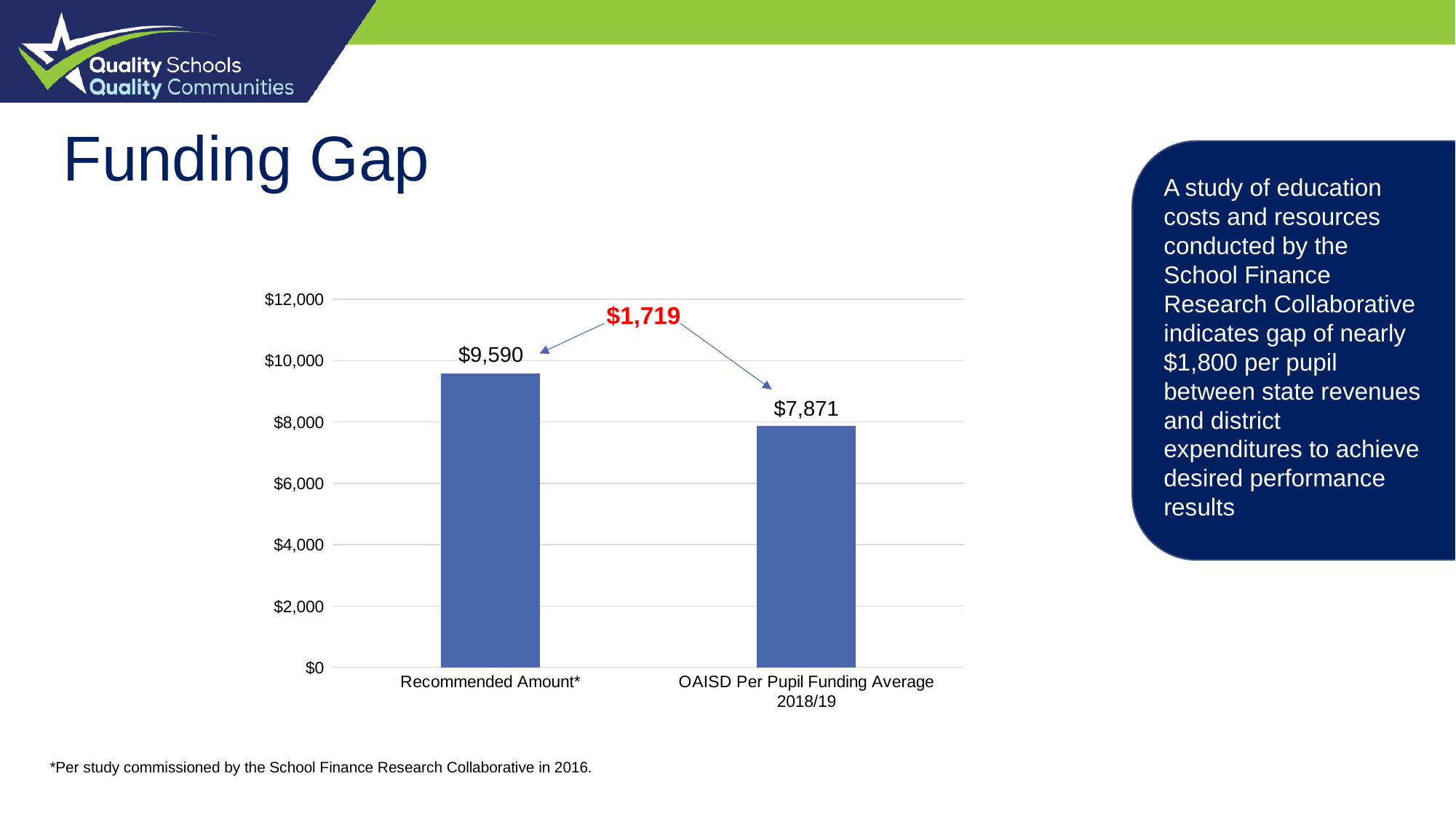
How many categories are shown on the chart? 2 Which category has the highest value? Recommended Amount* What is the highest value shown on the y axis? $12,000 What is the difference between the Recommended Amount* and the OAISD Per Pupil Funding Average 2018/19? $1,719 What is the value for OAISD Per Pupil Funding Average 2018/19? $7,871 What kind of chart is shown on the slide? bar chart Which category has the lowest value? OAISD Per Pupil Funding Average 2018/19 Which is larger, the Recommended Amount* or the OAISD Per Pupil Funding Average 2018/19? Recommended Amount* Is the value for Recommended Amount* greater or less than $8,000? greater What value is shown in red between the two bars? $1,719 What is the value for Recommended Amount*? $9,590 Is the value for OAISD Per Pupil Funding Average 2018/19 greater or less than $8,000? less